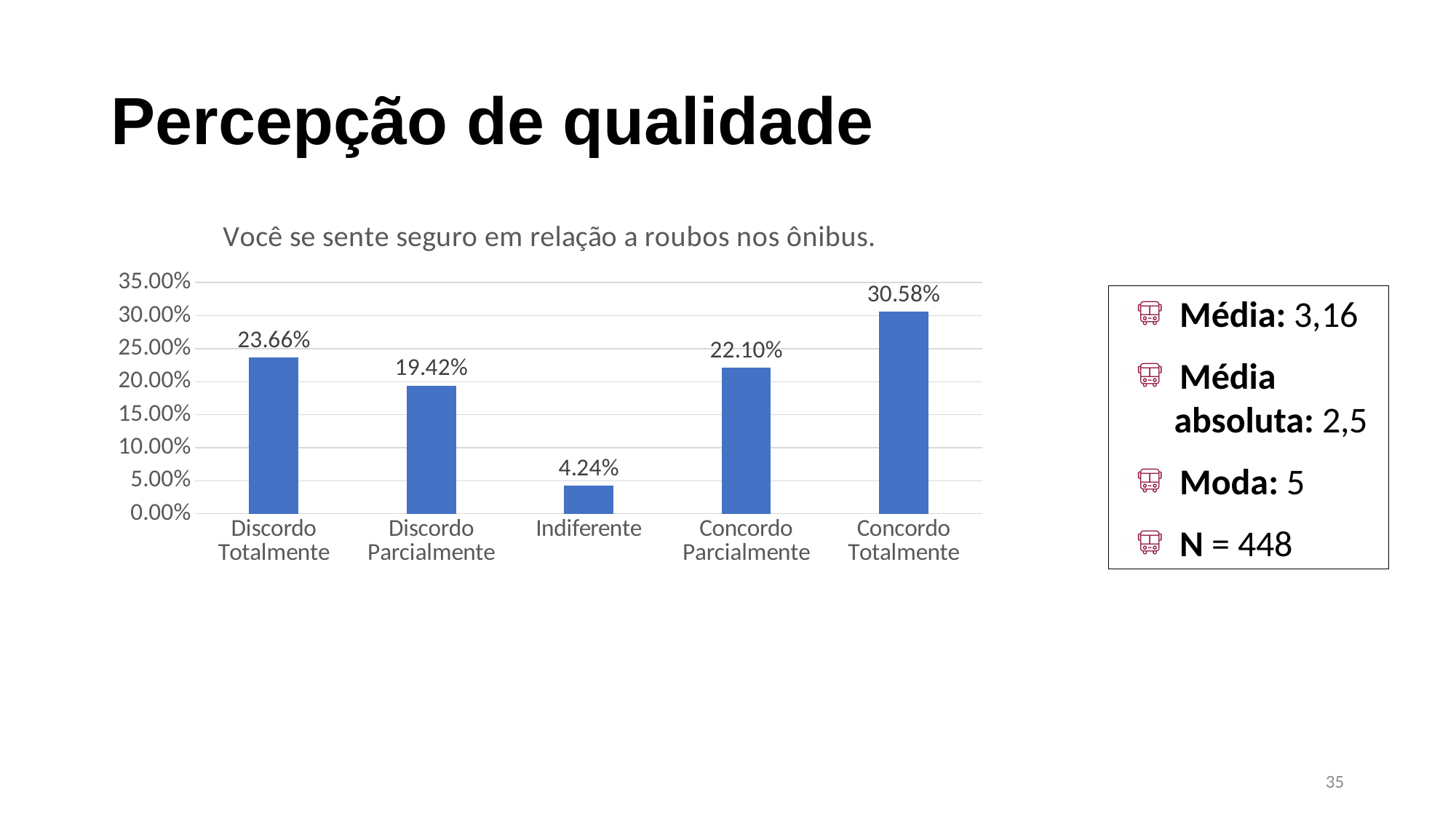
What is the difference between Discordo Totalmente and Discordo Parcialmente? 4.24% Is the value for Discordo Parcialmente greater or less than 20.00%? less Which category has the lowest value? Indiferente What is the difference between Concordo Totalmente and Discordo Totalmente? 6.92% What kind of chart is shown on the slide? bar chart Which category has the highest value? Concordo Totalmente What is the value for Discordo Totalmente? 23.66% How many categories are shown on the x axis? 5 Which is larger, Discordo Parcialmente or Concordo Parcialmente? Concordo Parcialmente What is the value for Indiferente? 4.24% What is the title of the chart? Você se sente seguro em relação a roubos nos ônibus. What is the value for Concordo Parcialmente? 22.10%